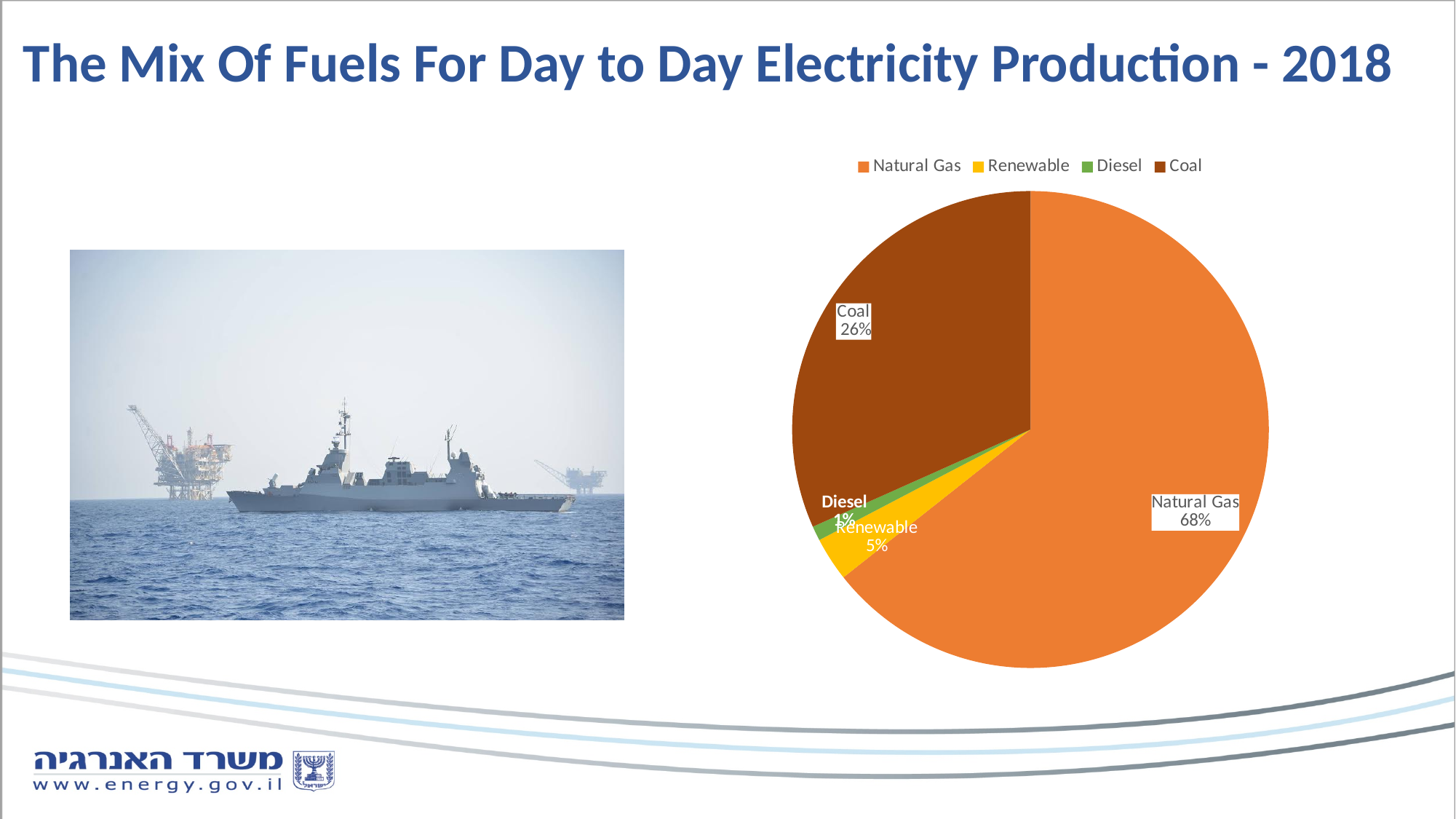
How many entries does the legend list? 4 What share of the pie does Renewable have? 5% Which has a larger share, Coal or Renewable? Coal What share of the pie does Natural Gas have? 68% How many fuel categories are shown in the pie chart? 4 Which fuel has the largest share of the pie? Natural Gas What kind of chart is shown on the slide? Pie chart What share of the pie does Coal have? 26% What share of the pie does Diesel have? 1% What is the difference in percentage points between the Natural Gas and Coal shares? 42 Which colour represents Renewable in the pie chart? Yellow Which fuel has the smallest share of the pie? Diesel